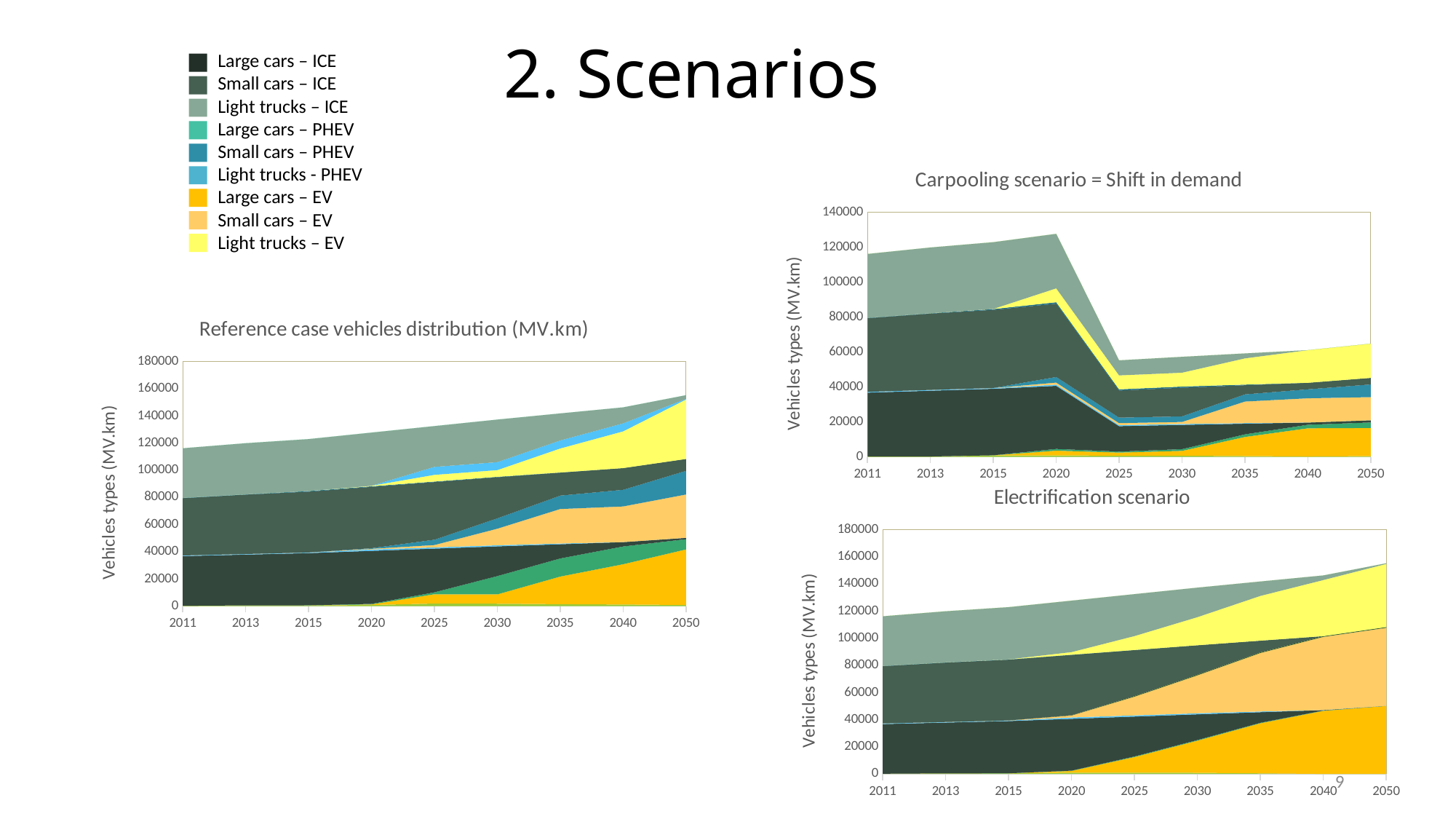
What is the title of the chart in the top right of the slide? Carpooling scenario = Shift in demand In the 'Carpooling scenario = Shift in demand' chart, is the total stacked value in 2020 greater or less than 100000? greater In the 'Reference case vehicles distribution (MV.km)' chart, is the total stacked value in 2011 greater or less than 120000? less In the 'Electrification scenario' chart, is the total stacked value in 2050 greater or less than 140000? greater How many years are shown on the x axis of the 'Electrification scenario' chart? 9 What kind of chart is the 'Reference case vehicles distribution (MV.km)' chart? Stacked area chart In the 'Electrification scenario' chart, does the total stacked value rise or fall from 2011 to 2050? rise In the 'Carpooling scenario = Shift in demand' chart, does the total stacked value rise or fall between 2020 and 2025? fall How many series does the legend on the slide list? 9 What is the y-axis label of the 'Electrification scenario' chart? Vehicles types (MV.km)